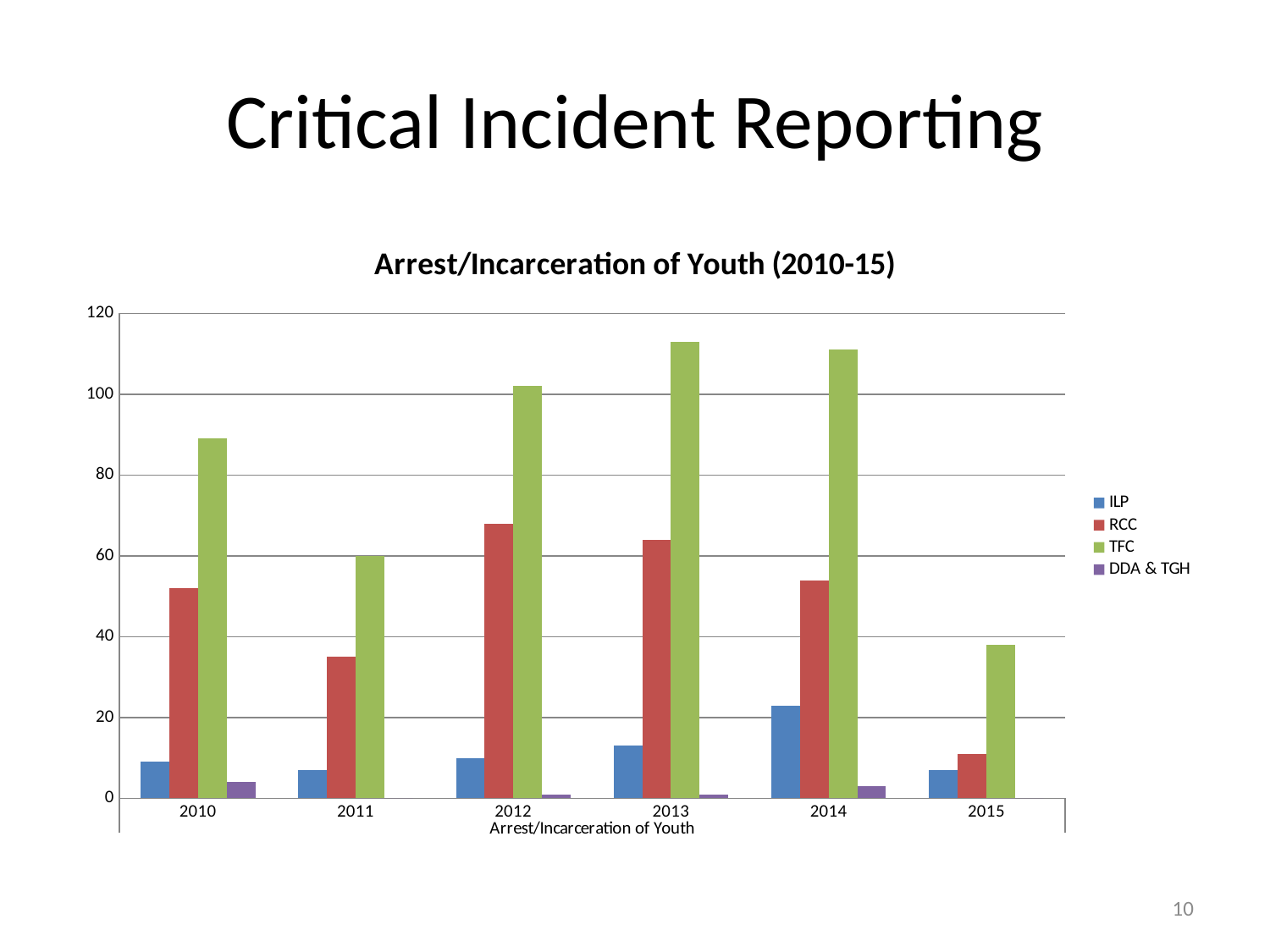
How many series does the legend list? 4 How many years are shown along the x axis? 6 Is the TFC value for 2012 greater or less than 100? greater What kind of chart is shown on the slide? bar chart Is the RCC value for 2011 greater or less than 40? less In which year is the RCC value lowest? 2015 Is the ILP value for 2014 greater or less than 20? greater In which year is the TFC value lowest? 2015 In 2010, which is larger, the RCC value or the TFC value? TFC In which year is the ILP value highest? 2014 What is the title of the chart? Arrest/Incarceration of Youth (2010-15) Which series has the tallest bar in every year shown? TFC